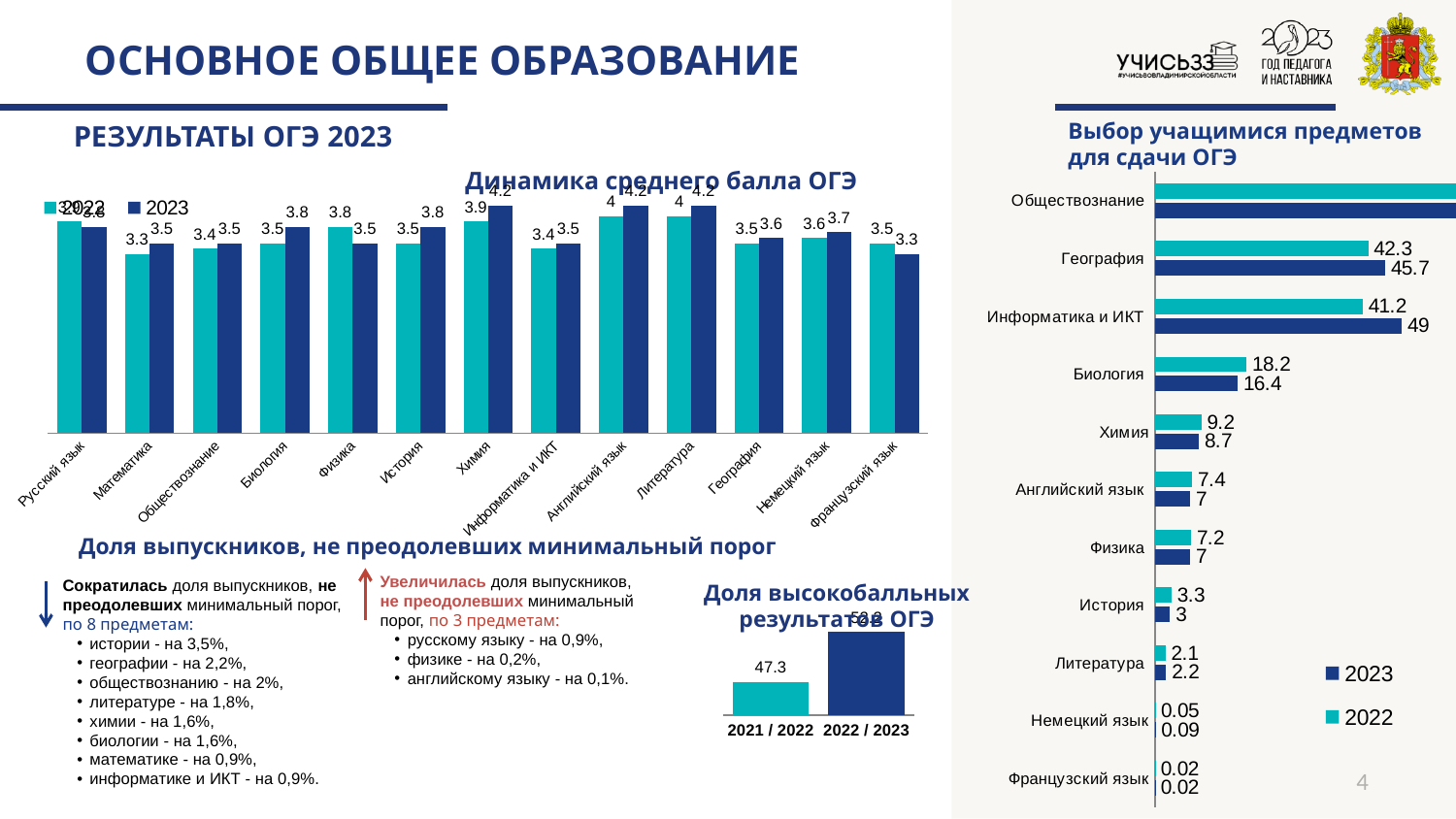
In the chart 'Выбор учащимися предметов для сдачи ОГЭ', what is the 2022 value for География? 42.3 In the chart 'Динамика среднего балла ОГЭ', what was the average score for Химия in 2023? 4.2 In the chart 'Динамика среднего балла ОГЭ', how many subjects are shown on the x axis? 13 What type of chart is 'Выбор учащимися предметов для сдачи ОГЭ'? Bar chart In the chart 'Доля высокобалльных результатов ОГЭ', what is the value for 2021 / 2022? 47.3 In the chart 'Динамика среднего балла ОГЭ', how many series does the legend list? 2 In the chart 'Выбор учащимися предметов для сдачи ОГЭ', which subject has the lowest values? Французский язык In the chart 'Динамика среднего балла ОГЭ', what was the average score for Математика in 2022? 3.3 In the chart 'Динамика среднего балла ОГЭ', by how much did the average score for Биология change from 2022 to 2023? 0.3 In the chart 'Динамика среднего балла ОГЭ', which is larger for Французский язык: the 2022 value or the 2023 value? 2022 In the chart 'Выбор учащимися предметов для сдачи ОГЭ', what is the 2023 value for Информатика и ИКТ? 49 In the chart 'Выбор учащимися предметов для сдачи ОГЭ', what is the difference between the 2022 and 2023 values for Биология? 1.8